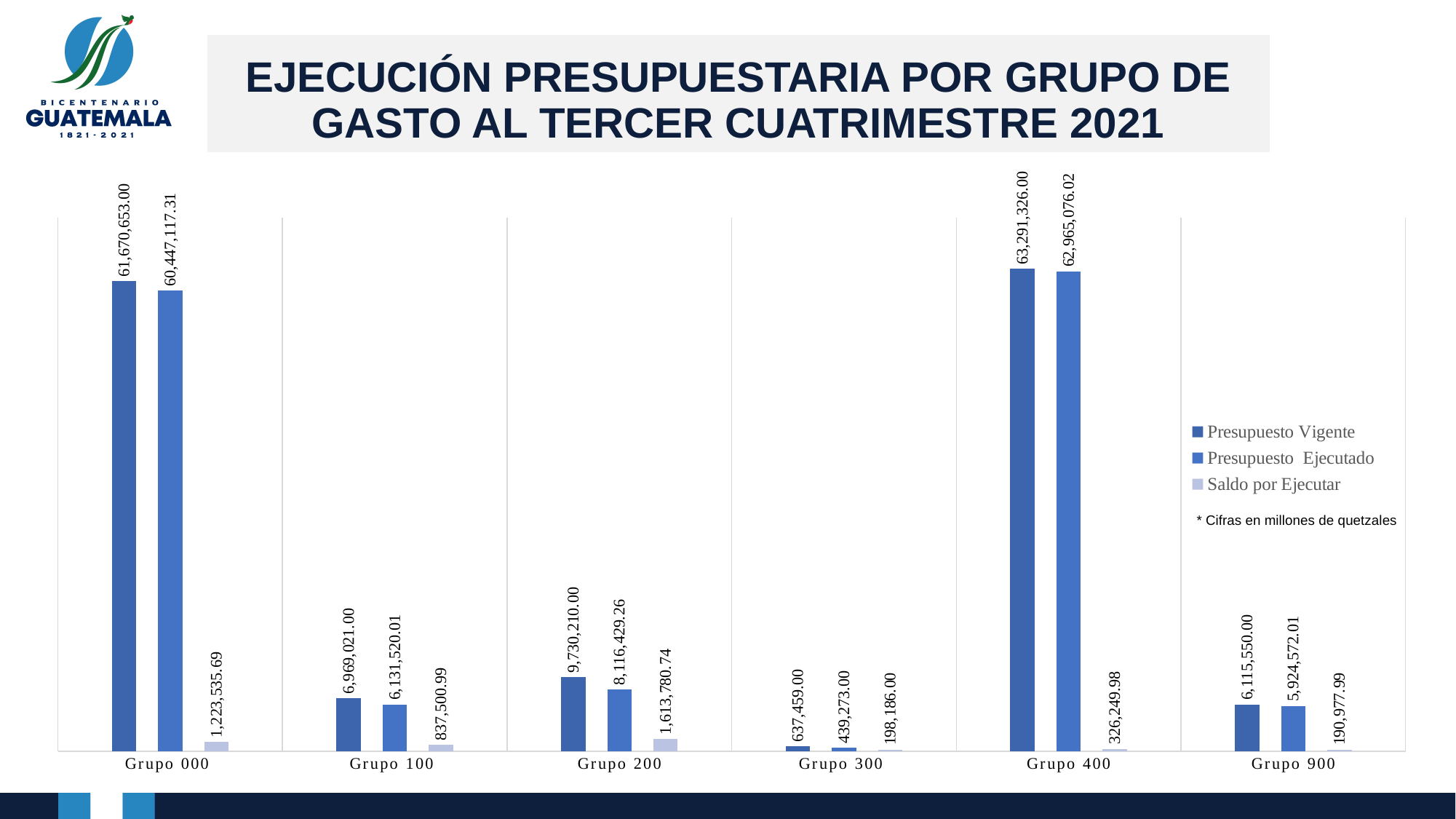
Which group has the lowest Presupuesto Ejecutado? Grupo 300 What is the Presupuesto Ejecutado value for Grupo 100? 6,131,520.01 What is the Saldo por Ejecutar value for Grupo 200? 1,613,780.74 What type of chart is shown on the slide? Bar chart What is the difference between Presupuesto Vigente and Presupuesto Ejecutado for Grupo 300? 198,186.00 Which group has the highest Presupuesto Vigente? Grupo 400 What is the Presupuesto Vigente value for Grupo 400? 63,291,326.00 Which is larger: the Saldo por Ejecutar for Grupo 000 or for Grupo 400? Grupo 000 How many series does the legend list? 3 What is the Presupuesto Ejecutado value for Grupo 900? 5,924,572.01 How many expense groups (categories) are shown on the x axis? 6 According to the note on the slide, in what unit are the figures expressed? Millones de quetzales